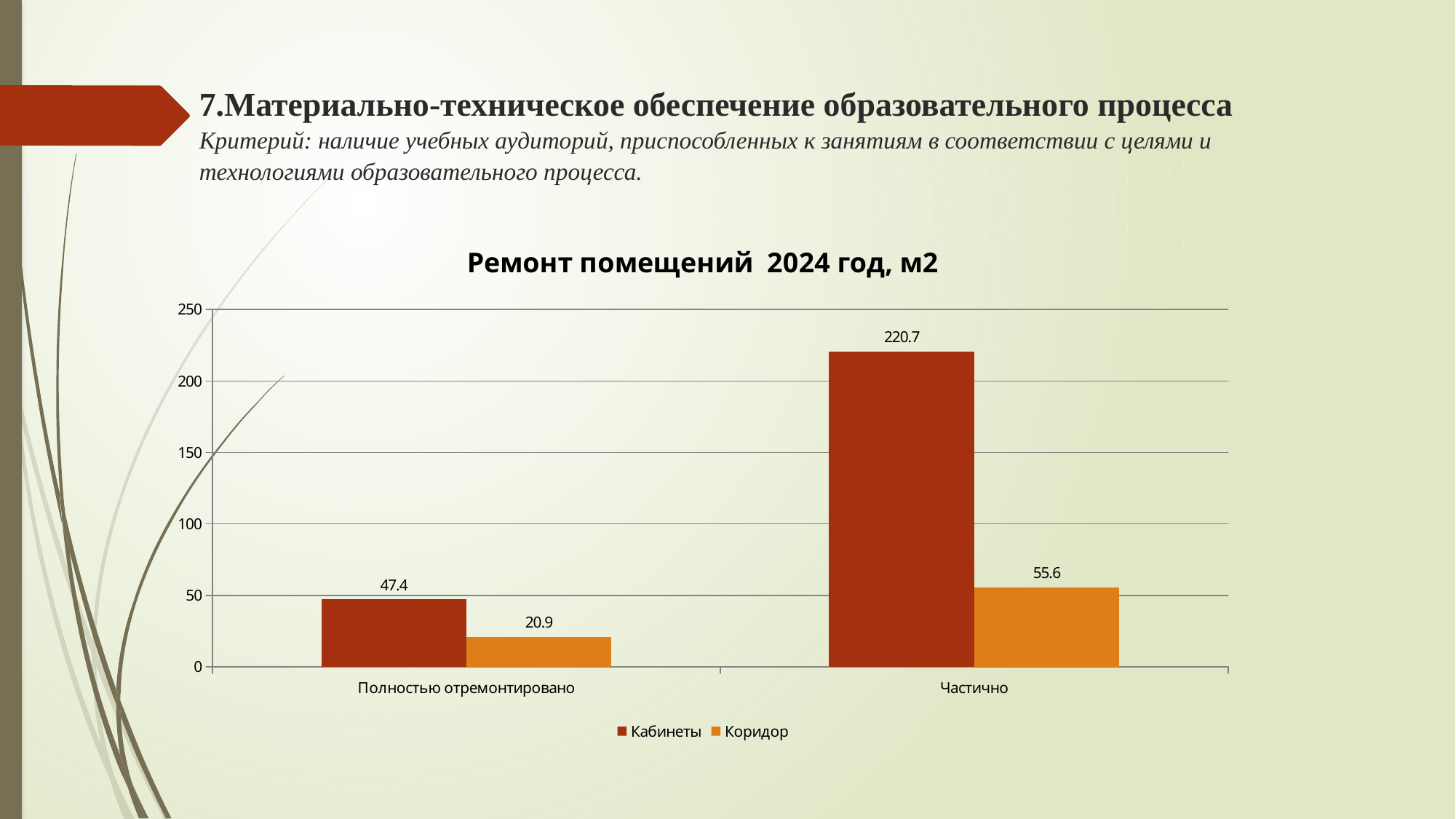
What is the value for Кабинеты in the Полностью отремонтировано category? 47.4 What is the value for Кабинеты in the Частично category? 220.7 Which bar has the highest value on the chart? Кабинеты, Частично How many series does the legend list? 2 Is the value for Кабинеты in the Частично category greater or less than 200? greater What is the difference between the Кабинеты values for Частично and Полностью отремонтировано? 173.3 What is the value for Коридор in the Полностью отремонтировано category? 20.9 What is the value for Коридор in the Частично category? 55.6 How many categories are shown on the x axis? 2 Which bar has the lowest value on the chart? Коридор, Полностью отремонтировано What is the title of the chart? Ремонт помещений 2024 год, м2 Which is larger in the Частично category: Кабинеты or Коридор? Кабинеты